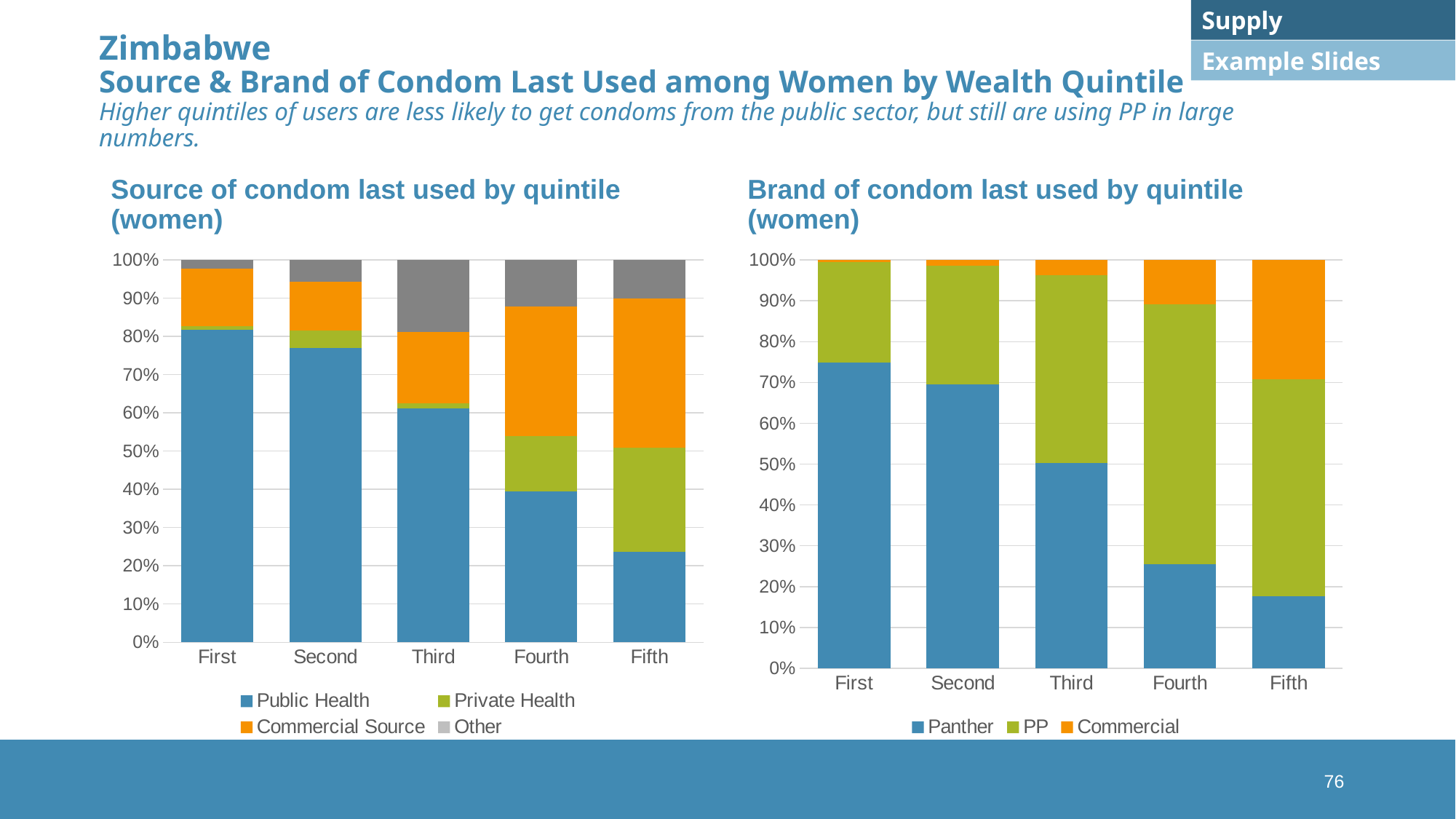
What kind of chart is the 'Source of condom last used by quintile (women)' chart? Stacked bar chart In the 'Brand of condom last used by quintile (women)' chart, which quintile has the highest Panther share? First How many wealth quintile categories are shown on the x axis of the 'Brand of condom last used by quintile (women)' chart? 5 In the 'Brand of condom last used by quintile (women)' chart, is the Panther share for the Fourth quintile greater or less than 30%? less In the 'Source of condom last used by quintile (women)' chart, which quintile has the lowest Public Health share? Fifth In the 'Brand of condom last used by quintile (women)' chart, which series is shown in orange? Commercial How many series does the legend of the 'Source of condom last used by quintile (women)' chart list? 4 In the 'Brand of condom last used by quintile (women)' chart, which quintile has the lowest Panther share? Fifth In the 'Source of condom last used by quintile (women)' chart, does the Public Health share rise or fall from First to Fifth quintile? Fall In the 'Source of condom last used by quintile (women)' chart, which quintile has the highest Public Health share? First In the 'Source of condom last used by quintile (women)' chart, is the Public Health share for the Fifth quintile greater or less than 30%? less How many series does the legend of the 'Brand of condom last used by quintile (women)' chart list? 3